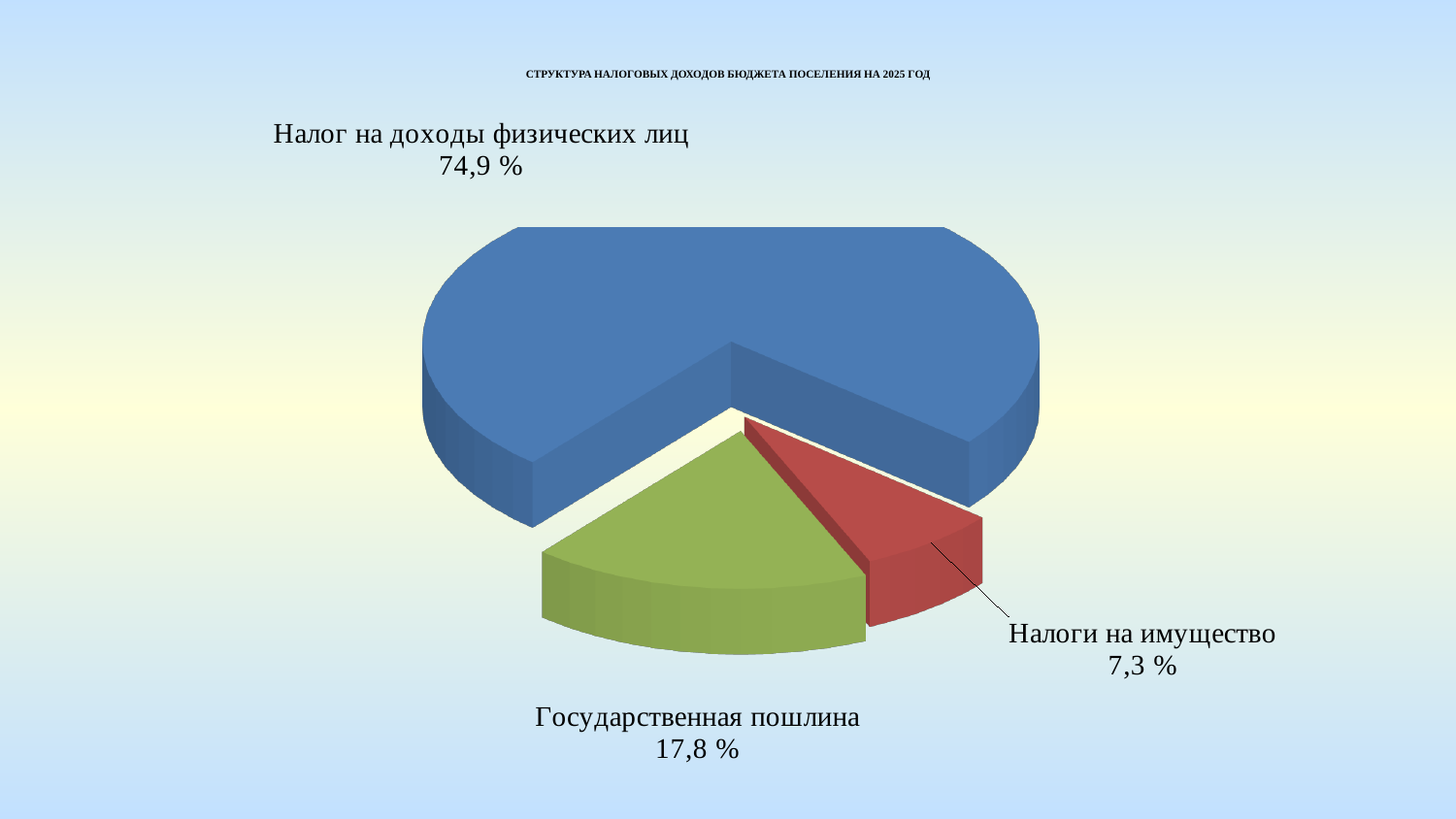
Какая категория имеет наименьшую долю? Налоги на имущество Какой тип диаграммы показан на слайде? Круговая диаграмма Что больше: доля государственной пошлины или доля налогов на имущество? Государственная пошлина На сколько процентных пунктов доля государственной пошлины больше доли налогов на имущество? 10,5 Какова доля государственной пошлины? 17,8 % Какова доля налогов на имущество? 7,3 % На сколько процентных пунктов доля налога на доходы физических лиц больше доли государственной пошлины? 57,1 Как называется диаграмма на слайде? Структура налоговых доходов бюджета поселения на 2025 год Какова доля налога на доходы физических лиц в структуре налоговых доходов? 74,9 % Каким цветом показан сектор «Государственная пошлина»? Зелёным Какая категория имеет наибольшую долю в структуре налоговых доходов? Налог на доходы физических лиц Сколько категорий показано на круговой диаграмме? 3